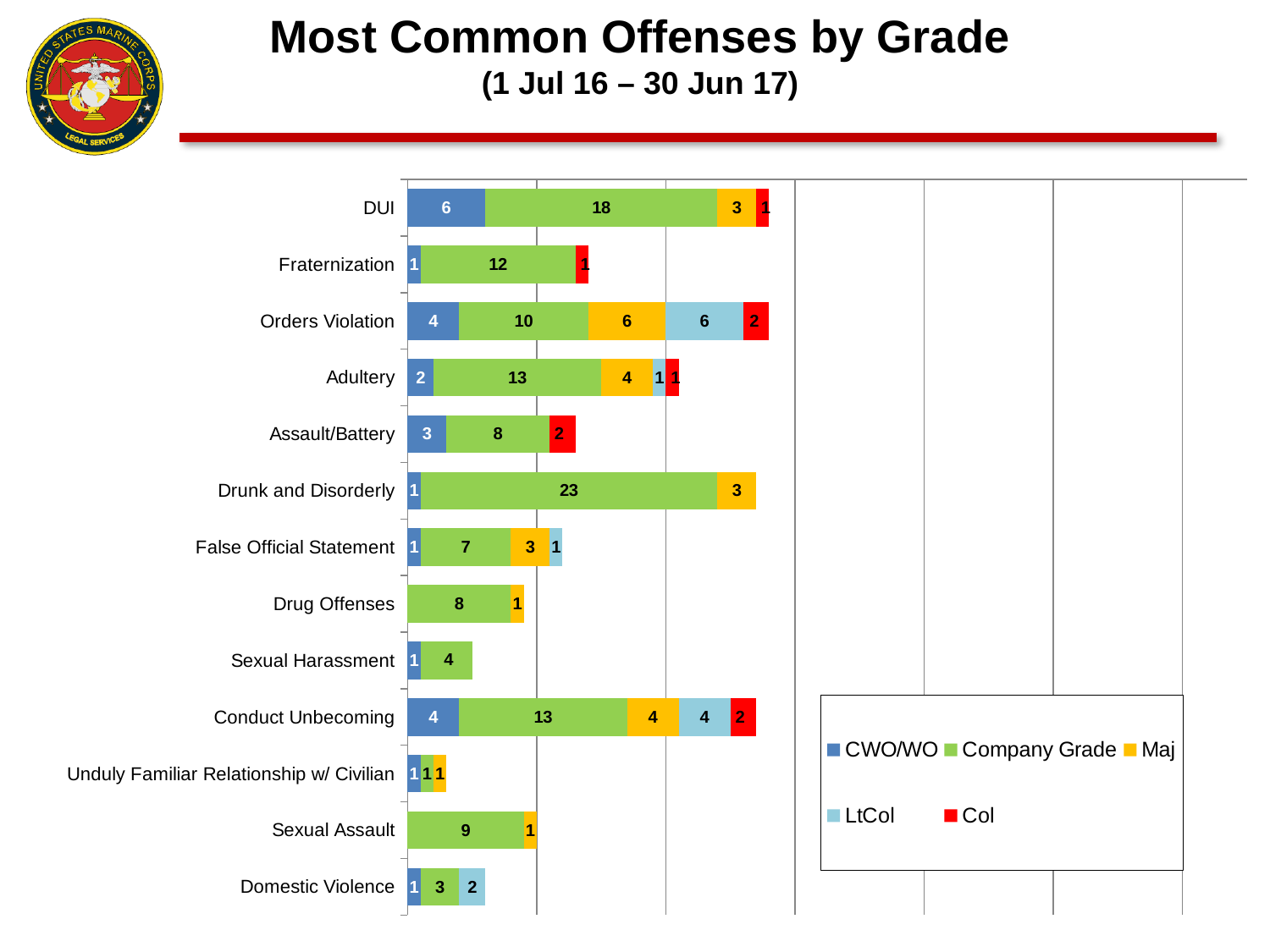
What type of chart is shown on the slide? Stacked bar chart What is the LtCol value for Conduct Unbecoming? 4 What is the total of the stacked bar for Adultery? 21 Which is larger, the CWO/WO value for DUI or the CWO/WO value for Orders Violation? DUI What is the Company Grade value for DUI? 18 Which offense has the lowest stacked bar total? Unduly Familiar Relationship w/ Civilian What is the total of the stacked bar for Conduct Unbecoming? 27 How many series does the legend list? 5 What is the difference between the Company Grade values for Drunk and Disorderly and Fraternization? 11 Which offense has the highest Company Grade value? Drunk and Disorderly How many offense categories are plotted on the chart? 13 What is the Maj value for Orders Violation? 6